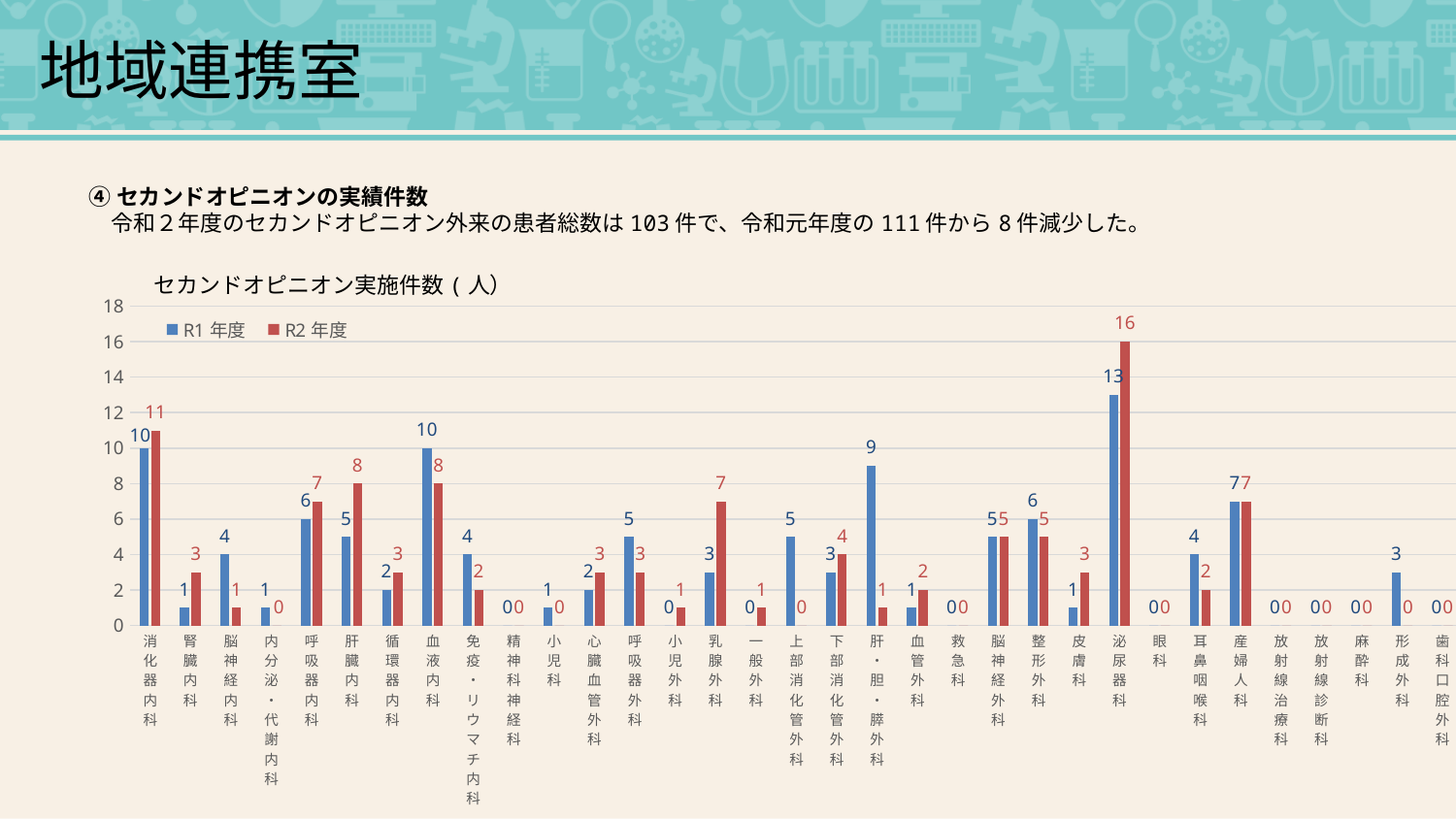
How many series does the legend list? 2 Which is larger for 血液内科, the R1 年度 value or the R2 年度 value? R1 年度 What kind of chart is shown on the slide? Bar chart What is the title of the chart? セカンドオピニオン実施件数（人） What is the difference between the R2 年度 and R1 年度 values for 泌尿器科? 3 What is the difference between the R1 年度 and R2 年度 values for 肝・胆・膵外科? 8 What is the R1 年度 value for 上部消化管外科? 5 Which colour represents R2 年度 in the chart? Red Which department has the highest R1 年度 value? 泌尿器科 What is the R2 年度 value for 泌尿器科? 16 What is the R2 年度 value for 乳腺外科? 7 What is the R1 年度 value for 肝・胆・膵外科? 9